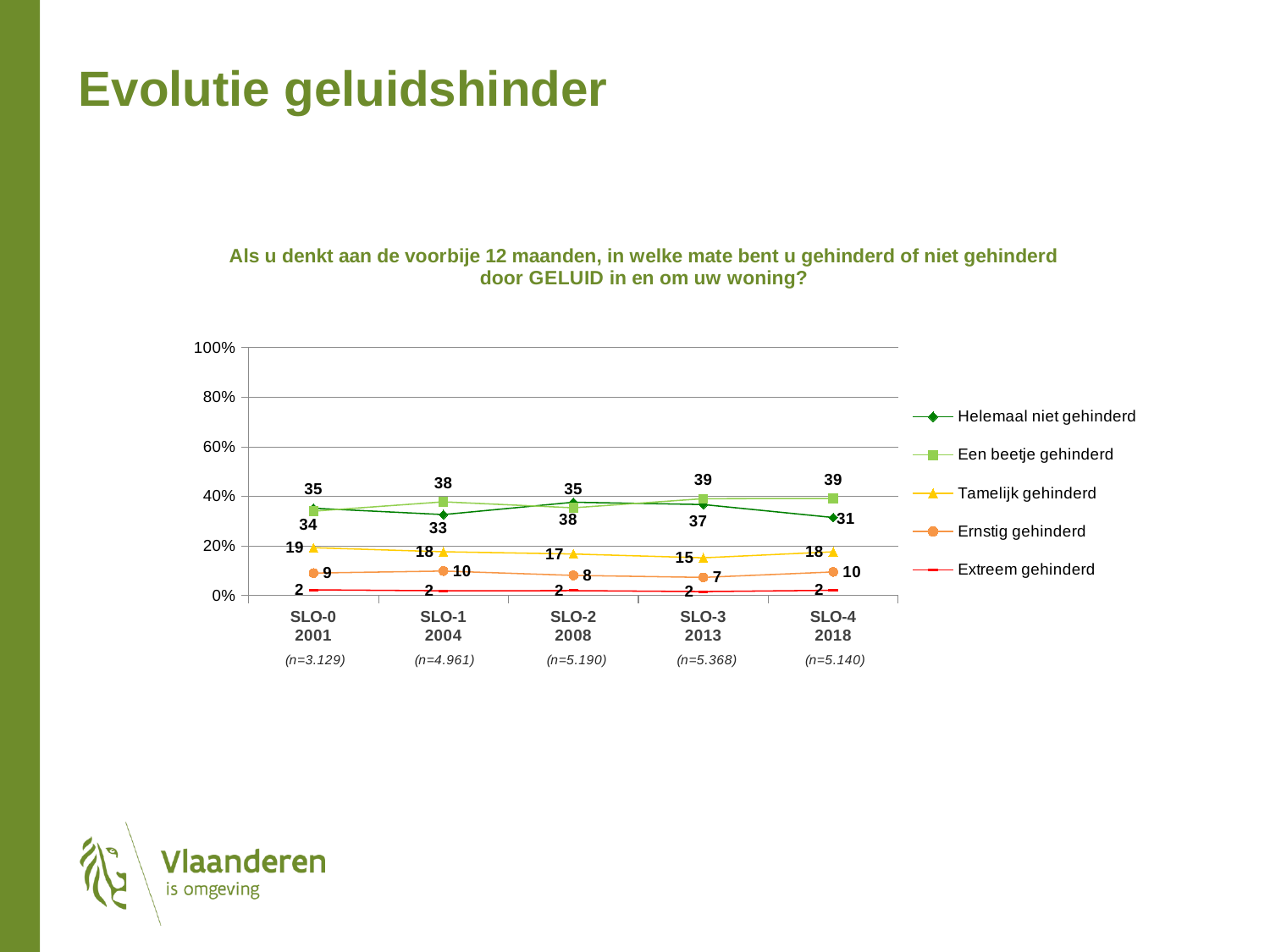
How many survey waves (points along the x axis) are plotted? 5 What is the value for 'Helemaal niet gehinderd' at SLO-4 2018? 31 What is the value for 'Tamelijk gehinderd' at SLO-3 2013? 15 Does the 'Extreem gehinderd' series rise, fall or stay the same across the survey waves? stays the same What is the value for 'Extreem gehinderd' at SLO-2 2008? 2 In which survey wave is 'Tamelijk gehinderd' at its lowest? SLO-3 2013 What type of chart is shown on the slide? line chart What is the value for 'Ernstig gehinderd' at SLO-1 2004? 10 How many series does the legend list? 5 What is the difference between the 'Tamelijk gehinderd' values at SLO-0 2001 and SLO-3 2013? 4 At SLO-4 2018, which is larger: 'Een beetje gehinderd' or 'Helemaal niet gehinderd'? Een beetje gehinderd What is the value for 'Een beetje gehinderd' at SLO-4 2018? 39